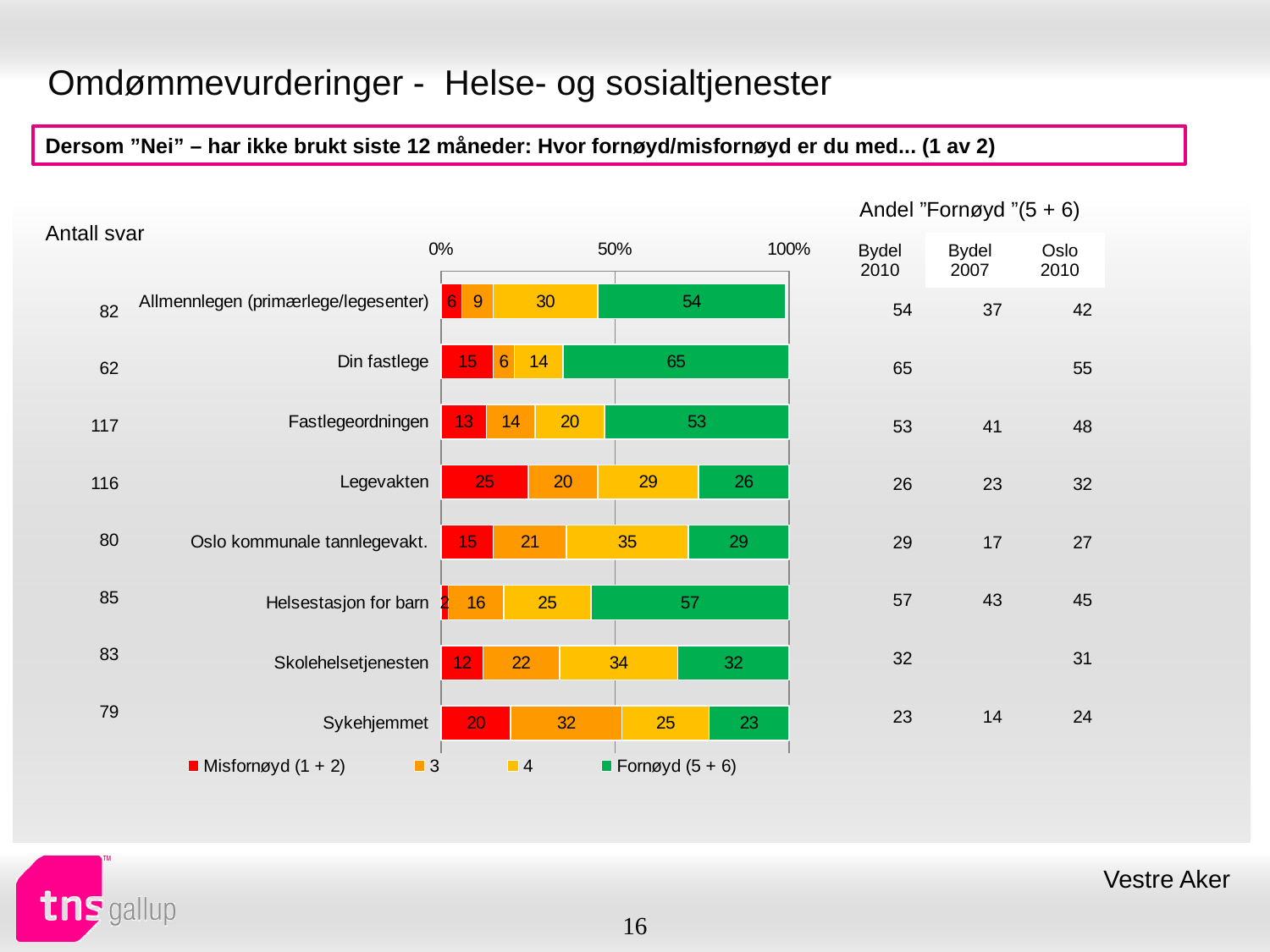
What is the difference between the 'Fornøyd (5 + 6)' values for Allmennlegen (primærlege/legesenter) and Skolehelsetjenesten? 22 What is the total of the stacked bar for Legevakten? 100 How many series does the chart legend list? 4 What is the value of the '4' segment for Oslo kommunale tannlegevakt.? 35 Which colour represents the 'Fornøyd (5 + 6)' series in the chart? green How many categories (services) are plotted in the chart? 8 Which category has the lowest 'Fornøyd (5 + 6)' value? Sykehjemmet What kind of chart is shown on the slide? stacked bar chart Which category has the highest 'Fornøyd (5 + 6)' value? Din fastlege What is the value of the 'Fornøyd (5 + 6)' segment for Din fastlege? 65 Which has a larger 'Misfornøyd (1 + 2)' value, Sykehjemmet or Fastlegeordningen? Sykehjemmet What is the value of the 'Misfornøyd (1 + 2)' segment for Legevakten? 25